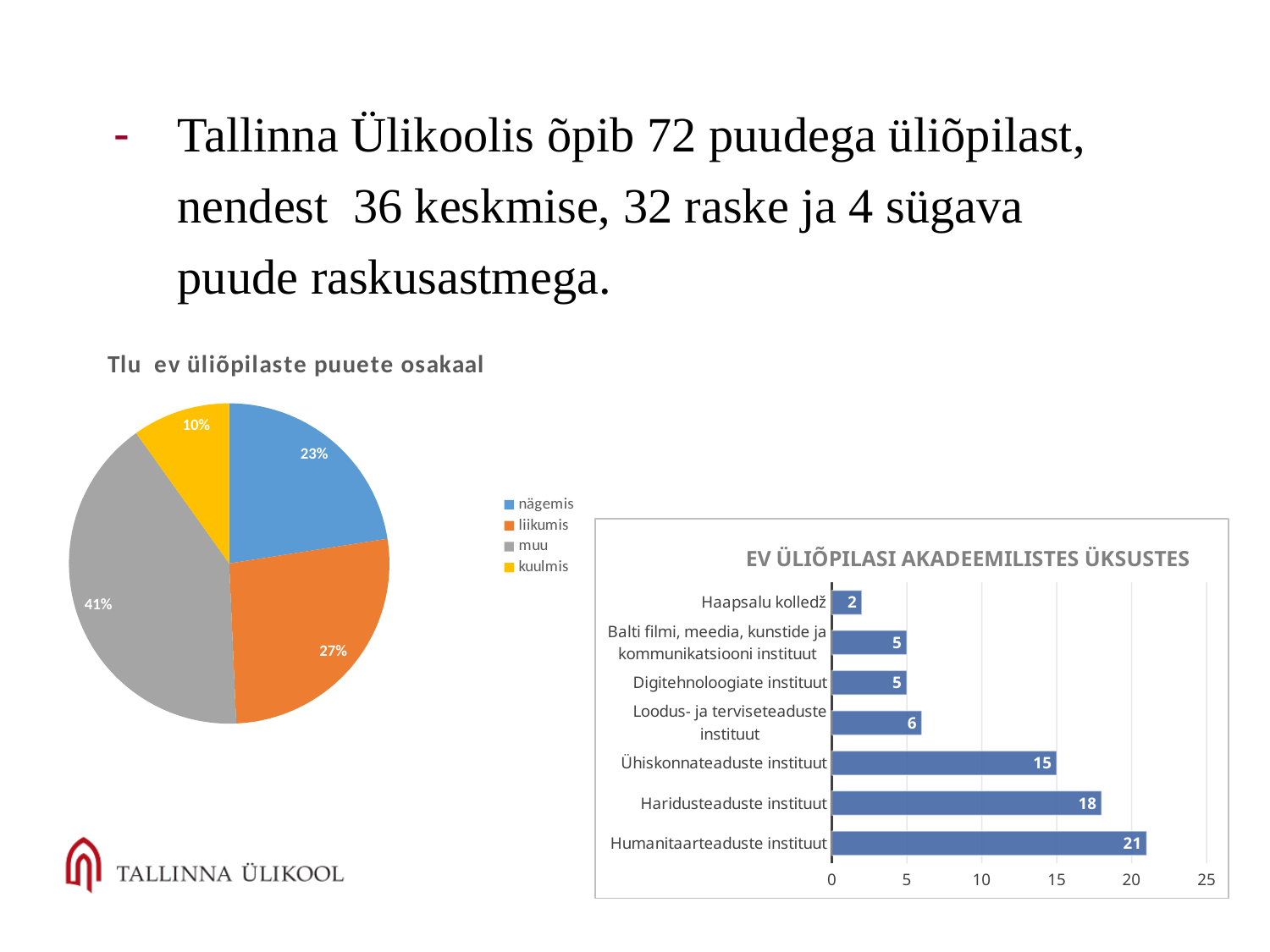
In the pie chart 'Tlu ev üliõpilaste puuete osakaal', which category has the largest share? muu In the chart 'EV ÜLIÕPILASI AKADEEMILISTES ÜKSUSTES', what is the difference between Humanitaarteaduste instituut and Ühiskonnateaduste instituut? 6 In the pie chart 'Tlu ev üliõpilaste puuete osakaal', what share does 'nägemis' have? 23% In the chart 'EV ÜLIÕPILASI AKADEEMILISTES ÜKSUSTES', what is the value for Haridusteaduste instituut? 18 What kind of chart is 'EV ÜLIÕPILASI AKADEEMILISTES ÜKSUSTES'? bar chart In the pie chart 'Tlu ev üliõpilaste puuete osakaal', what is the difference between the shares of 'liikumis' and 'kuulmis'? 17% In the pie chart 'Tlu ev üliõpilaste puuete osakaal', how many categories does the legend list? 4 In the chart 'EV ÜLIÕPILASI AKADEEMILISTES ÜKSUSTES', which unit has the lowest value? Haapsalu kolledž In the pie chart 'Tlu ev üliõpilaste puuete osakaal', what share does 'muu' have? 41% In the pie chart 'Tlu ev üliõpilaste puuete osakaal', which category has the smallest share? kuulmis In the chart 'EV ÜLIÕPILASI AKADEEMILISTES ÜKSUSTES', which unit has the highest value? Humanitaarteaduste instituut In the chart 'EV ÜLIÕPILASI AKADEEMILISTES ÜKSUSTES', how many academic units are shown? 7